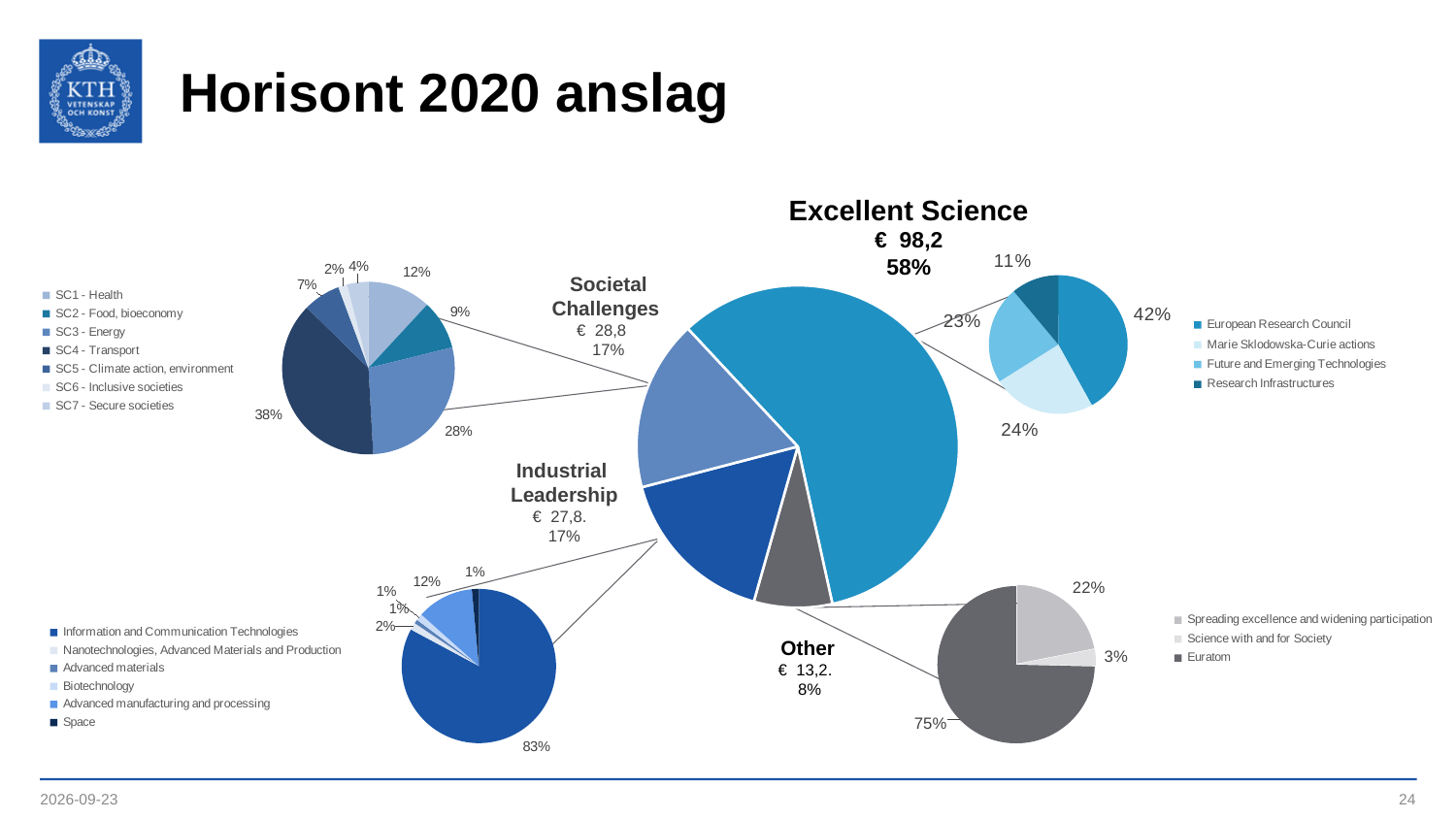
In the central pie chart, what is the difference in percentage points between Excellent Science and Other? 50 How many categories does the legend for the Societal Challenges sub-pie list? 7 In the Industrial Leadership sub-pie, what share does Information and Communication Technologies have? 83% In the Other sub-pie, what share does Euratom have? 75% In the Other sub-pie, which is larger: Spreading excellence and widening participation or Science with and for Society? Spreading excellence and widening participation In the central pie chart, what amount in euros is shown for Societal Challenges? € 28,8 In the Excellent Science sub-pie, which category has the smallest share? Research Infrastructures In the Excellent Science sub-pie, what share does the European Research Council have? 42% In the central pie chart, which segment is the smallest? Other In the central pie chart, what share does Excellent Science have? 58% What type of chart is used on this slide? pie chart In the central pie chart, which segment is the largest? Excellent Science